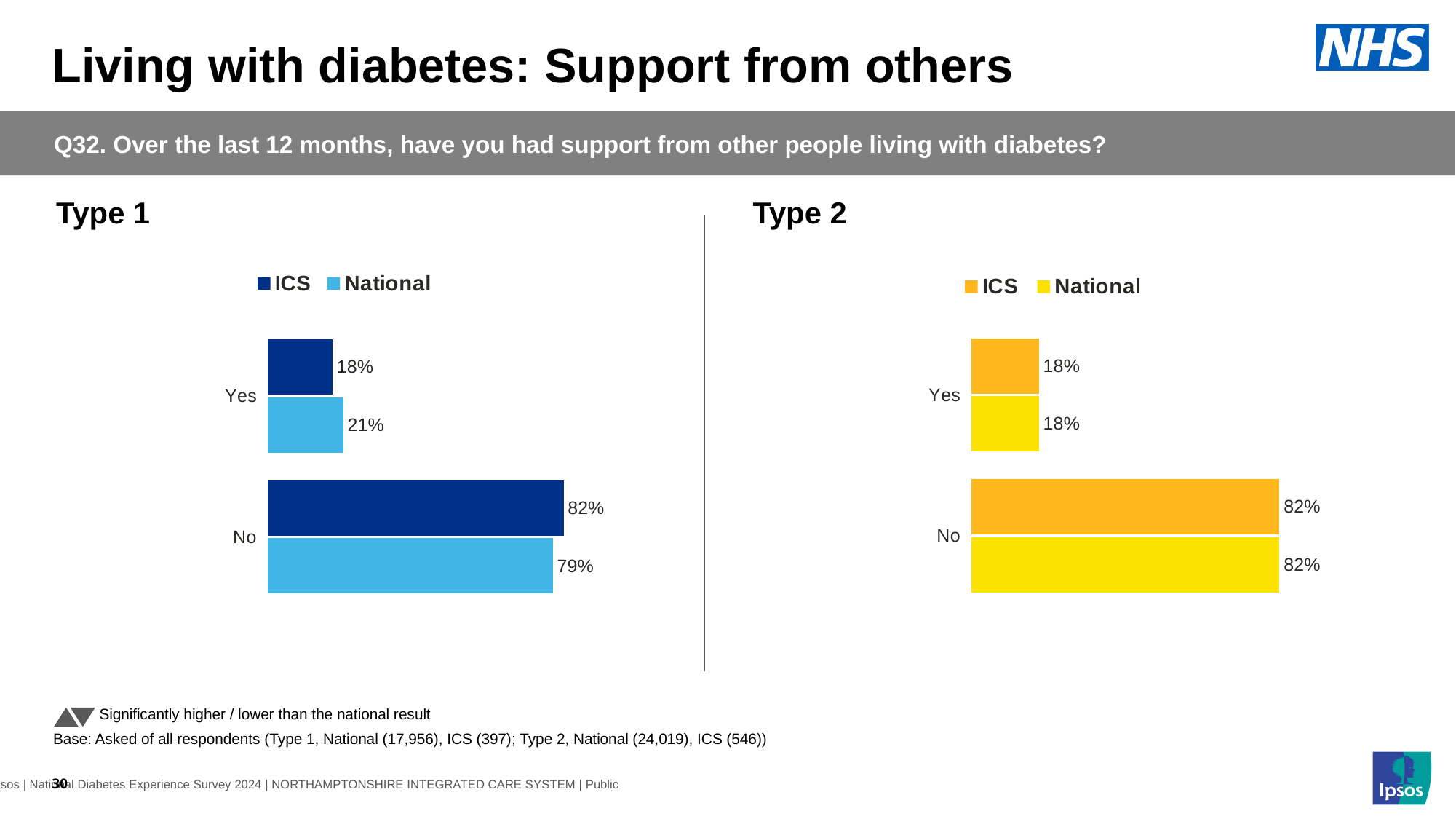
In the Type 1 chart, which colour represents the National series? Light blue How many response categories are shown in the Type 1 chart? 2 What kind of chart is the Type 2 chart? Bar chart How many series does the legend of the Type 2 chart list? 2 In the Type 1 chart, which response category has the highest ICS value? No In the Type 2 chart, what is the ICS value for No? 82% In the Type 1 chart, what is the ICS value for Yes? 18% In the Type 2 chart, what is the National value for Yes? 18% In the Type 2 chart, which response category has the lowest National value? Yes In the Type 1 chart, what is the difference between the National and ICS values for Yes? 3 percentage points In the Type 1 chart, which is larger for No: ICS or National? ICS In the Type 1 chart, what is the National value for No? 79%